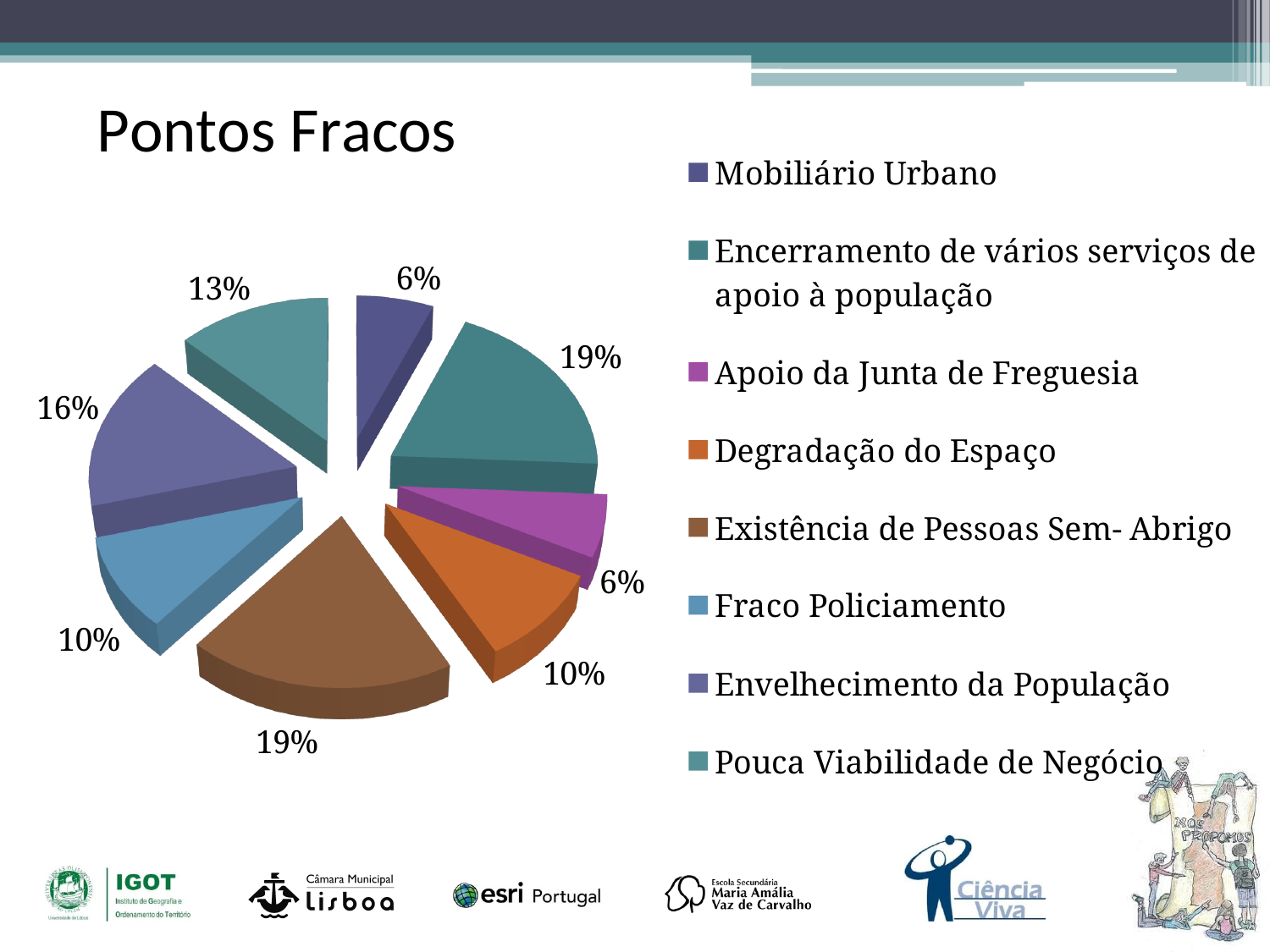
What percentage is shown for Pouca Viabilidade de Negócio? 13% Which has a larger share, Envelhecimento da População or Fraco Policiamento? Envelhecimento da População What is the title of the chart? Pontos Fracos What percentage is shown for Encerramento de vários serviços de apoio à população? 19% What is the largest percentage shown on the pie chart? 19% What percentage is shown for Degradação do Espaço? 10% What is the smallest percentage shown on the pie chart? 6% How many categories does the pie chart have? 8 What share does Envelhecimento da População have? 16% What share of the pie does Mobiliário Urbano represent? 6% What is the difference between the shares of Envelhecimento da População and Pouca Viabilidade de Negócio? 3% What kind of chart is shown on the slide? pie chart